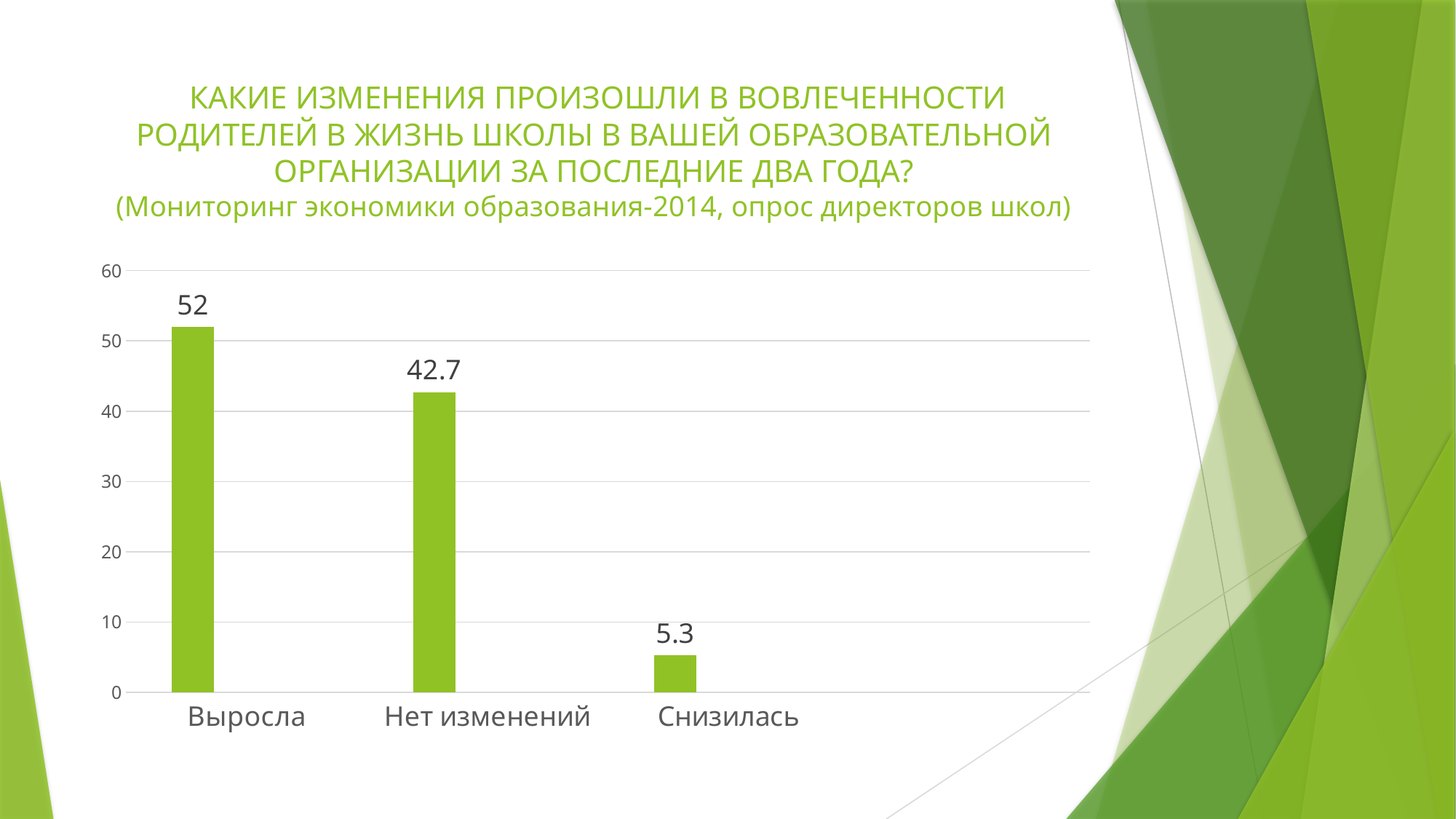
Which category has the lowest value? Снизилась What is the value for "Нет изменений"? 42.7 What is the difference between the values for "Нет изменений" and "Снизилась"? 37.4 Is the value for "Нет изменений" greater or less than 40? greater Do the values rise or fall from left to right along the x axis? fall Which category has the highest value? Выросла What kind of chart is shown on the slide? bar chart What is the value for "Выросла"? 52 What is the difference between the values for "Выросла" and "Нет изменений"? 9.3 Which is larger, the value for "Выросла" or the value for "Снизилась"? Выросла How many categories are shown on the x axis? 3 What is the value for "Снизилась"? 5.3